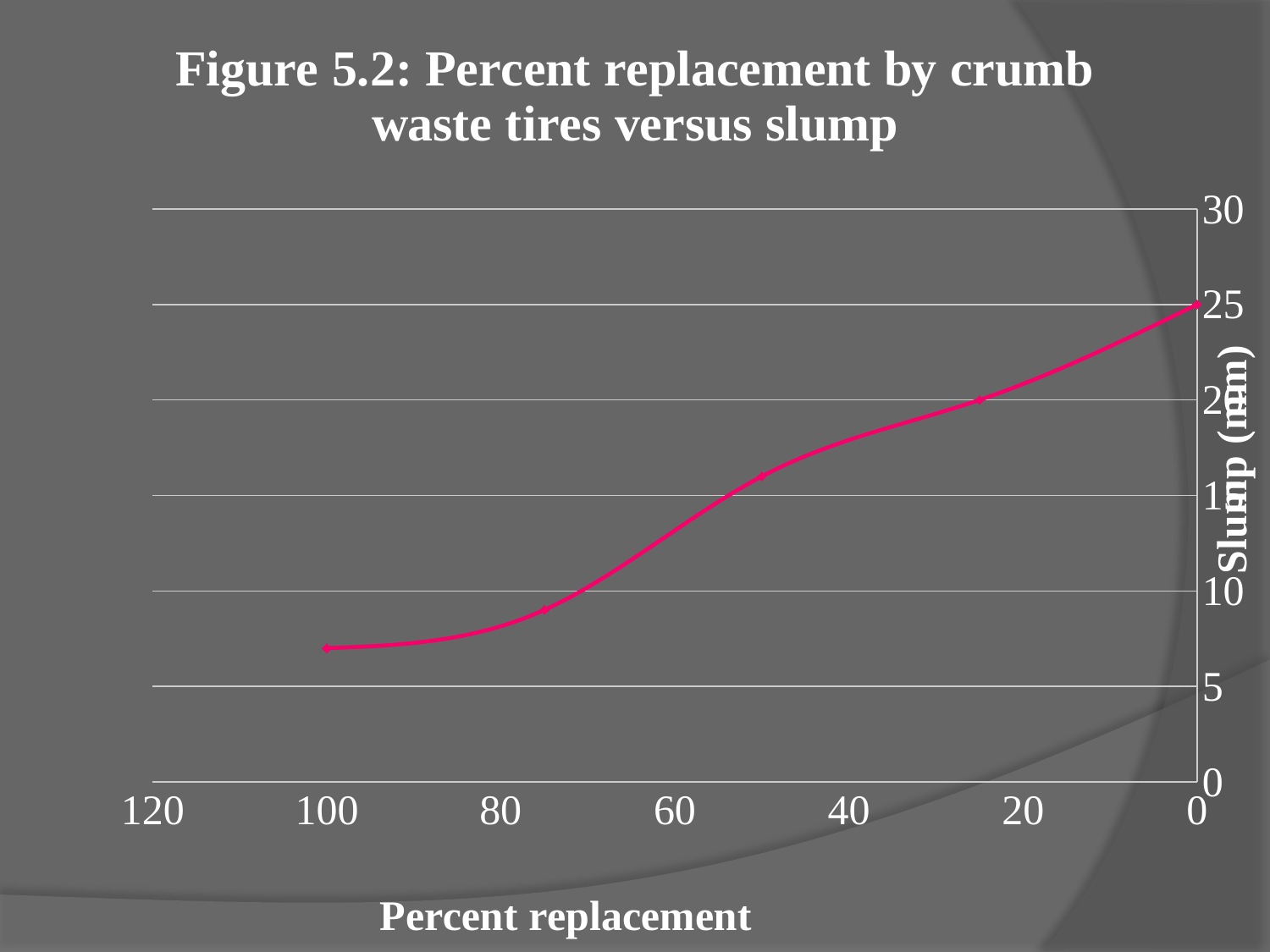
Is the slump at 50 percent replacement greater or less than 15? greater How many data points are plotted on the line? 5 Which has a larger slump: 25 percent replacement or 75 percent replacement? 25 percent replacement What is the slump (mm) at 0 percent replacement? 25 At which percent replacement is the slump lowest? 100 What kind of chart is shown on the slide? line chart What is the slump (mm) at 25 percent replacement? 20 What is the label of the y axis? Slump (mm) Is the slump at 100 percent replacement greater or less than 10? less Do the slump values rise or fall as the line moves from left to right along the x axis? rise At which percent replacement is the slump highest? 0 Is the slump at 75 percent replacement greater or less than 10? less